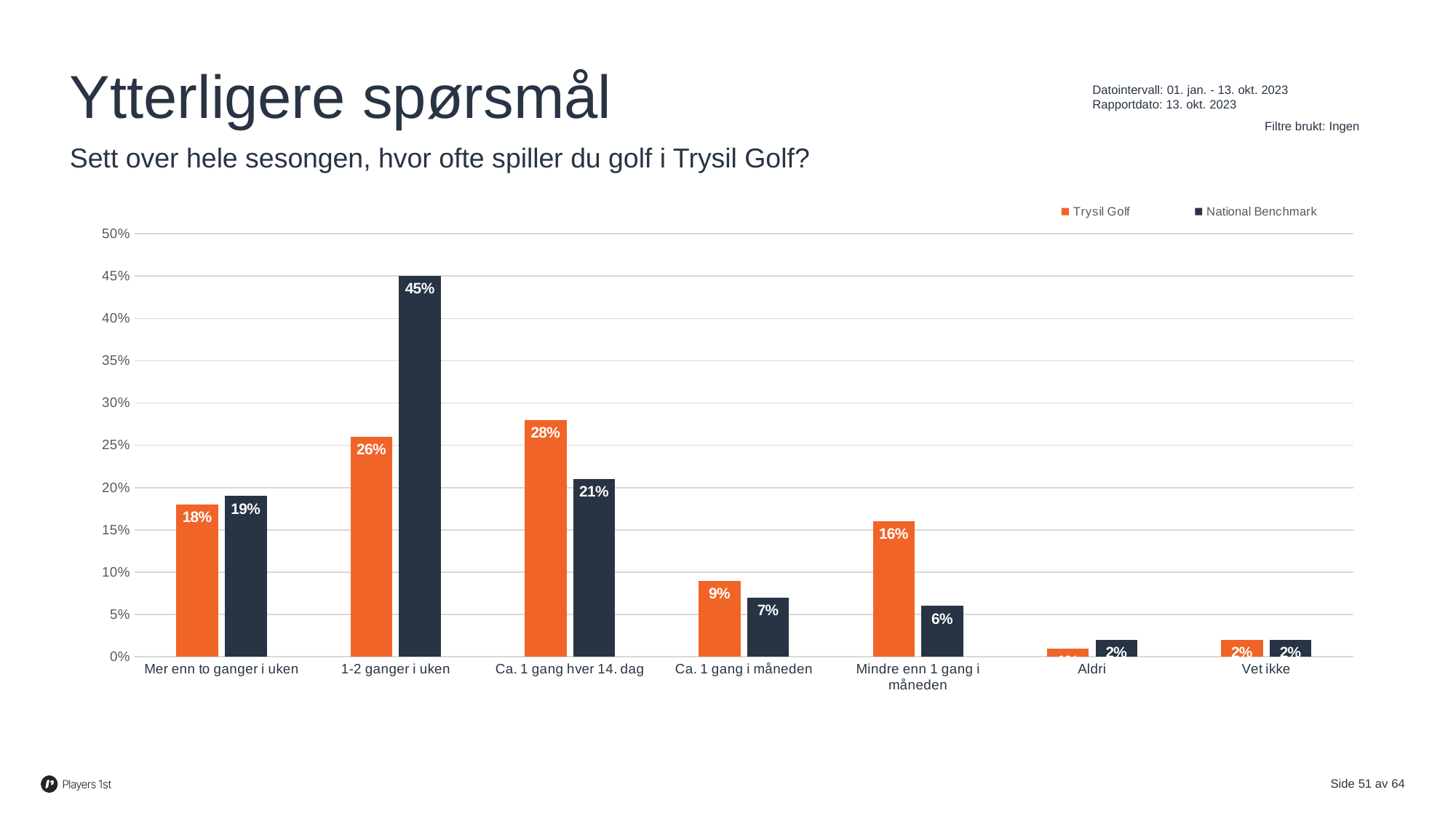
Is the National Benchmark value for "1-2 ganger i uken" greater or less than 40%? greater What is the Trysil Golf value for "1-2 ganger i uken"? 26% What is the National Benchmark value for "Ca. 1 gang hver 14. dag"? 21% Which colour represents the Trysil Golf series? Orange Which category has the highest Trysil Golf value? Ca. 1 gang hver 14. dag What kind of chart is shown on the slide? Bar chart For "Mindre enn 1 gang i måneden", which series has the larger value, Trysil Golf or National Benchmark? Trysil Golf How many categories are shown on the x axis? 7 What is the difference between the National Benchmark and Trysil Golf values for "1-2 ganger i uken"? 19% What is the Trysil Golf value for "Mindre enn 1 gang i måneden"? 16% Which category has the highest National Benchmark value? 1-2 ganger i uken How many series does the legend list? 2